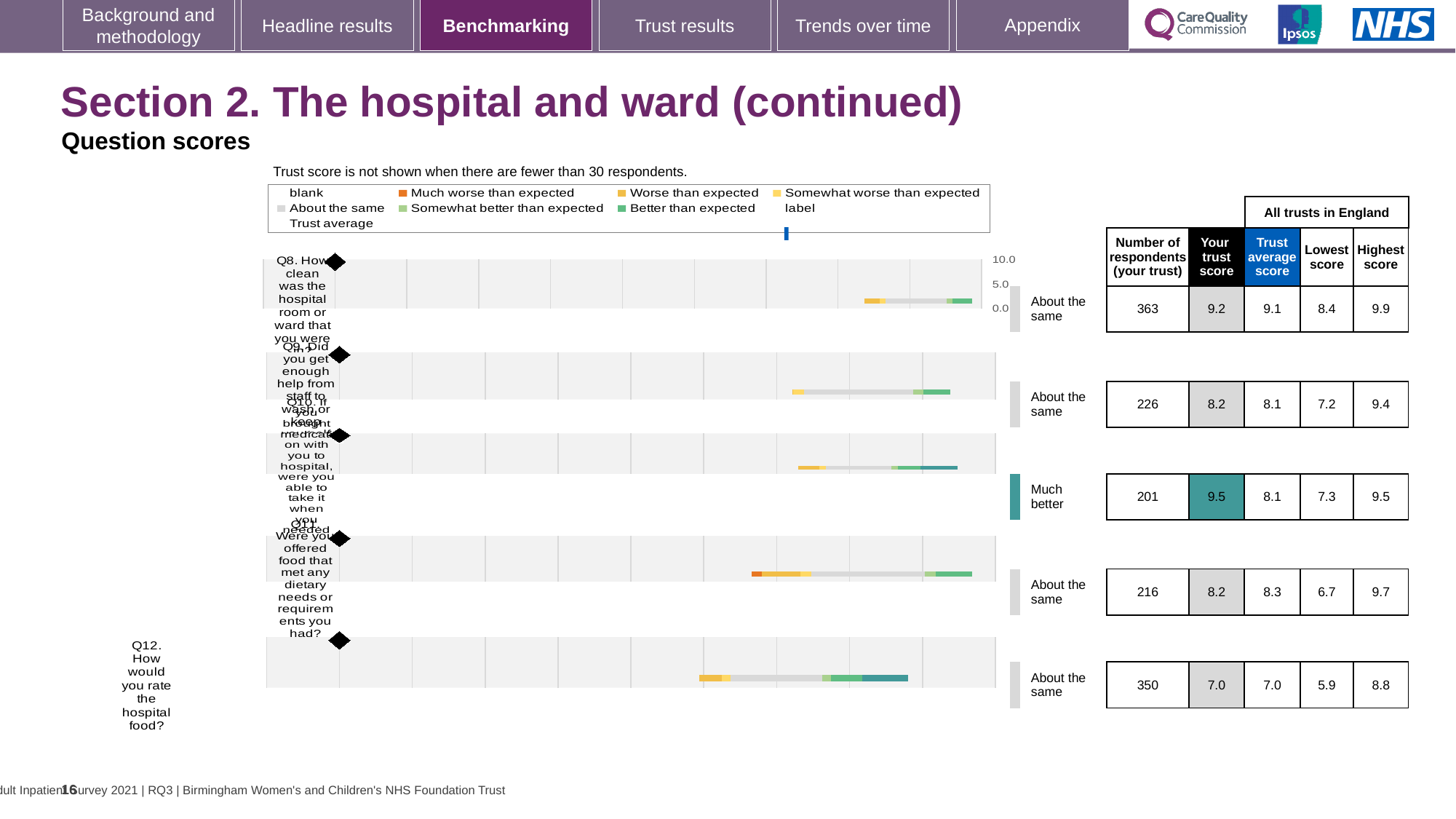
What is the lowest score across all trusts in England for Q11? 6.7 According to the note above the chart, the trust score is not shown when there are fewer than how many respondents? 30 How many respondents does the table show for Q12 (how would you rate the hospital food)? 350 Which question has the highest 'Your trust score' on this slide? Q10 What is the highest score across all trusts in England for Q9? 9.4 What is the 'Your trust score' value for Q8 (how clean was the hospital room or ward)? 9.2 What kind of chart is used to show the question scores on this slide? bar chart How many questions (rows) are plotted in the question scores chart? 5 Which question has the lowest 'Your trust score' on this slide? Q12 For Q8, which is larger: 'Your trust score' or the 'Trust average score'? Your trust score Which question is rated 'Much better' rather than 'About the same'? Q10 For Q10, what is the difference between 'Your trust score' and the 'Trust average score'? 1.4